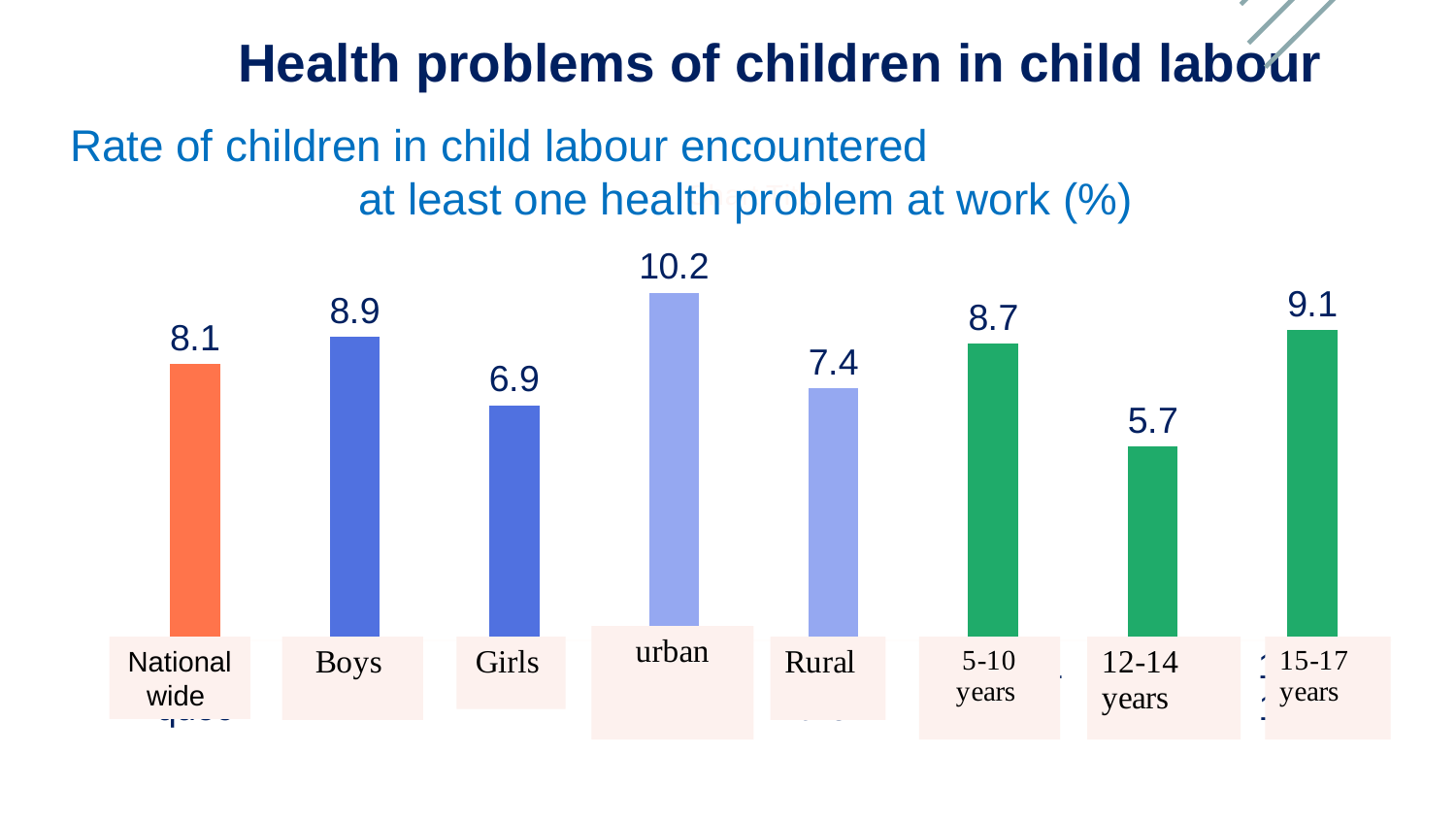
Which category has the highest value on the chart? urban What is the difference between the values for Boys and Girls? 2 Which category has the lowest value on the chart? 12-14 years How many categories are plotted on the chart? 8 What is the rate of children in child labour who encountered at least one health problem at work for Boys? 8.9 What is the difference between the urban and Rural values? 2.8 Which has a higher value, 5-10 years or 15-17 years? 15-17 years What is the value shown for children aged 12-14 years? 5.7 What kind of chart is shown on the slide? bar chart What is the title of the chart? Rate of children in child labour encountered at least one health problem at work (%) What is the National wide rate shown on the chart? 8.1 What is the value shown for the urban category? 10.2